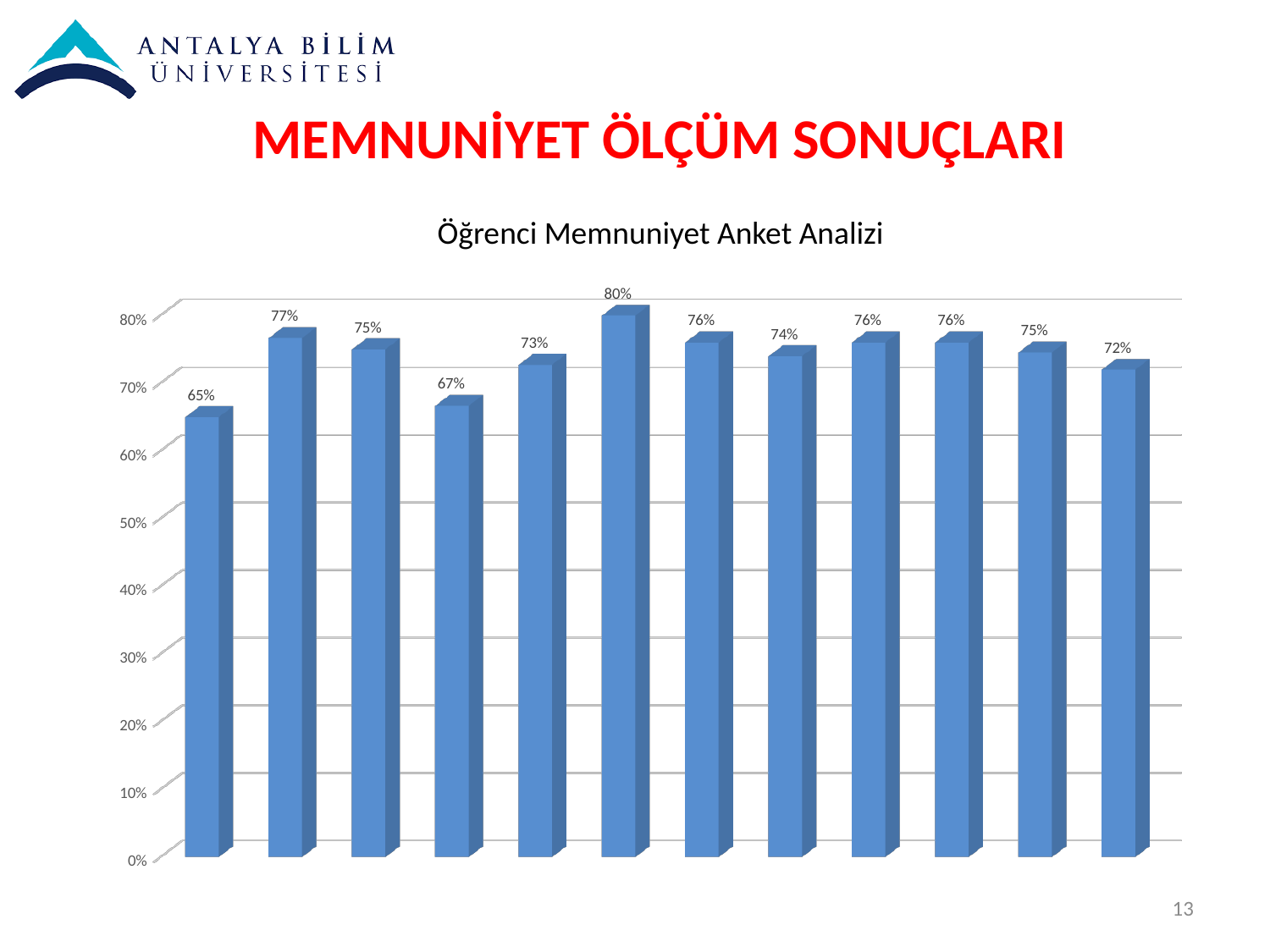
What is the lowest value shown in the chart? 65% Which is larger, the value of the fourth bar from the left or the value of the fifth bar from the left? the fifth bar (73%) What is the value of the first (leftmost) bar? 65% What is the value of the last (rightmost) bar? 72% What kind of chart is shown on the slide? bar chart What is the value of the sixth bar from the left? 80% Is the value of the first (leftmost) bar greater or less than 70%? less What is the highest value shown in the chart? 80% What is the value of the second bar from the left? 77% How many bars are plotted in the chart? 12 What is the title of the chart? Öğrenci Memnuniyet Anket Analizi What is the difference between the highest bar (80%) and the lowest bar (65%)? 15%